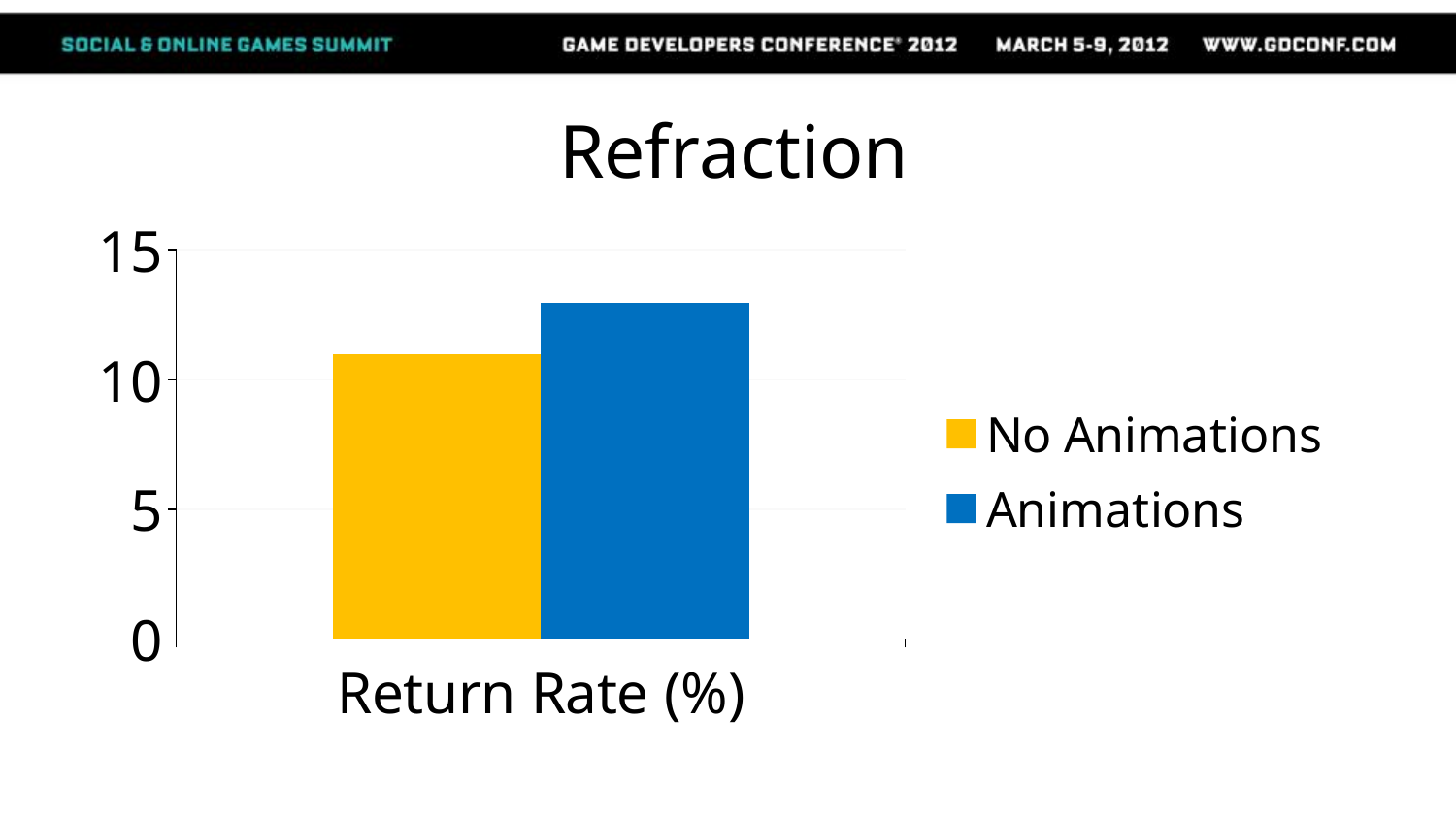
Is the Return Rate (%) for No Animations greater or less than 15? less What is the title of the chart? Refraction How many categories are shown on the x axis? 1 Is the Return Rate (%) for No Animations greater or less than 10? greater What kind of chart is shown on the slide? bar chart Is the Return Rate (%) for Animations greater or less than 15? less What is the label of the category on the x axis? Return Rate (%) Which series has the higher Return Rate (%), No Animations or Animations? Animations How many series does the legend list? 2 Which series has the lowest Return Rate (%)? No Animations Which series has the highest Return Rate (%)? Animations